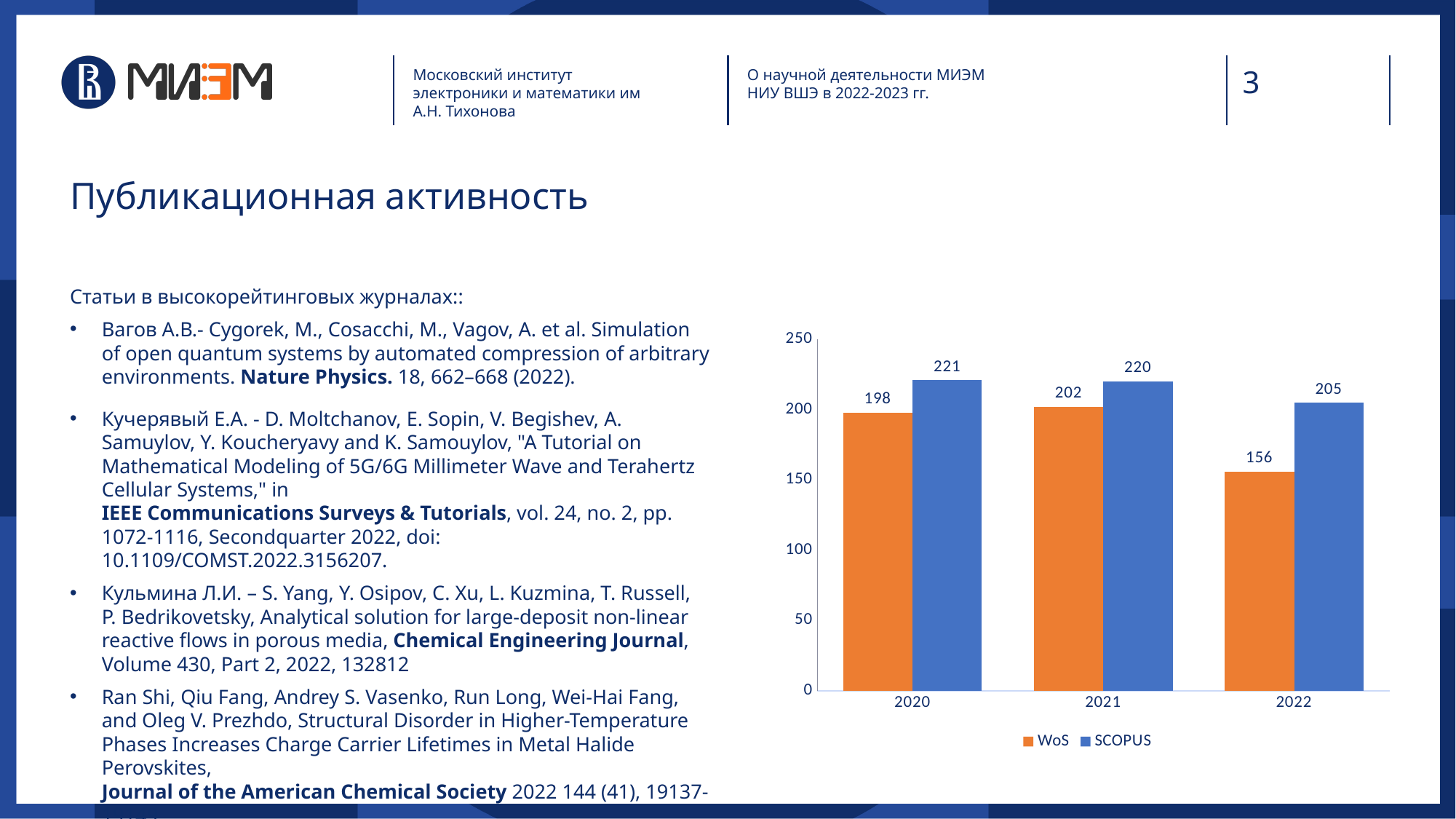
What is the SCOPUS value for 2022? 205 What is the difference between the WoS values for 2021 and 2022? 46 What is the SCOPUS value for 2021? 220 What kind of chart is shown on the slide? bar chart Is the WoS value for 2022 greater or less than 200? less Which is larger in 2021, the WoS value or the SCOPUS value? SCOPUS What is the WoS value for 2020? 198 What is the difference between the SCOPUS and WoS values in 2022? 49 How many years are shown on the x axis of the chart? 3 Which year has the highest SCOPUS value? 2020 How many series does the chart legend list? 2 Which year has the lowest WoS value? 2022